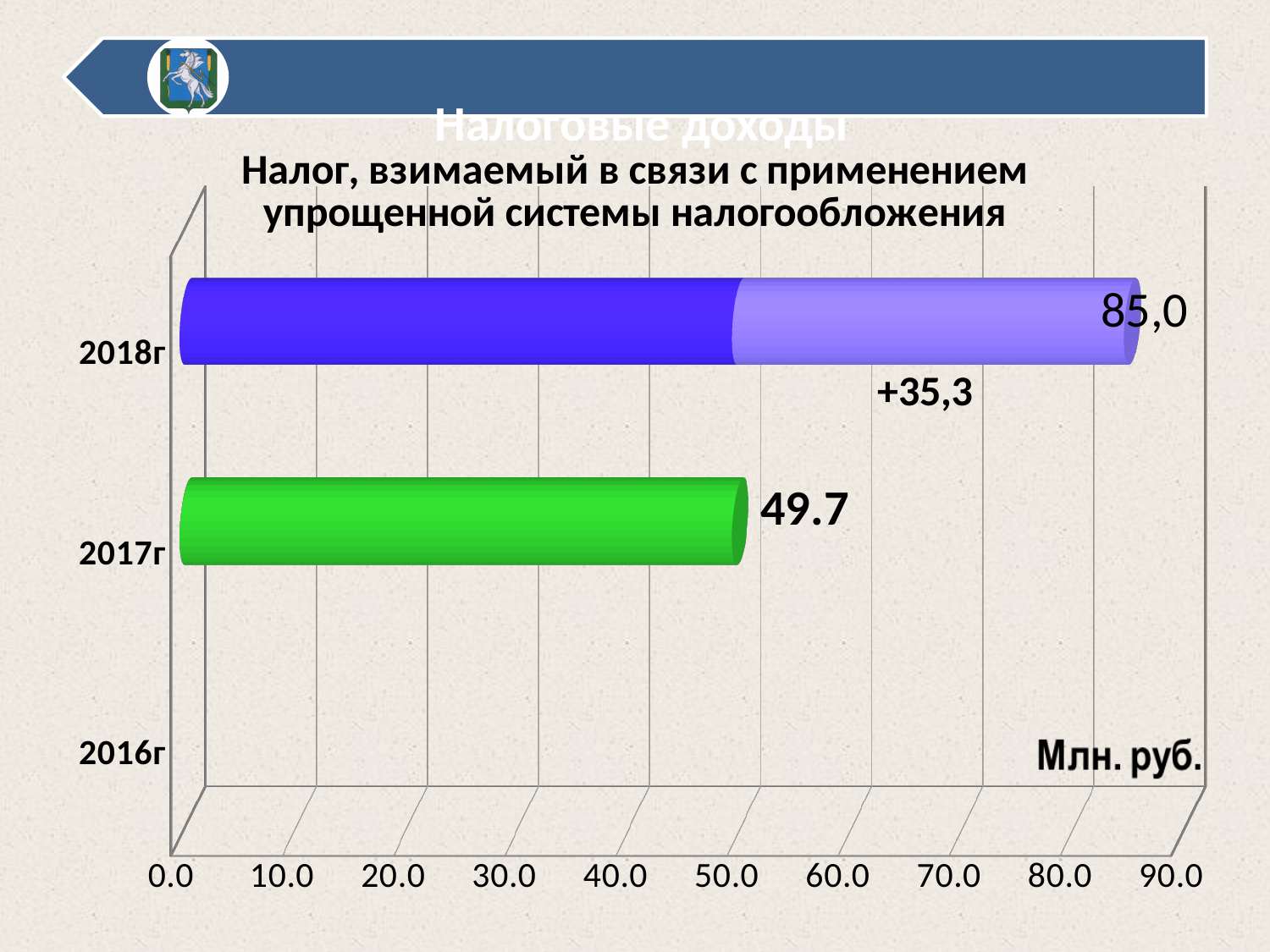
What is the value for 2017г? 49.7 Which year has the highest value? 2018г How many year categories are listed on the vertical axis? 3 By how much does the value for 2018г exceed the value for 2017г? 35,3 What is the value for 2018г? 85,0 What kind of chart is shown on the slide? bar chart Is the value for 2017г greater or less than 40.0? greater Do the values rise or fall from 2017г to 2018г? rise Which is larger, the value for 2018г or the value for 2017г? 2018г Is the value for 2018г greater or less than 80.0? greater What unit of measurement is shown on the chart? Млн. руб. What is the highest tick value shown on the horizontal axis? 90.0